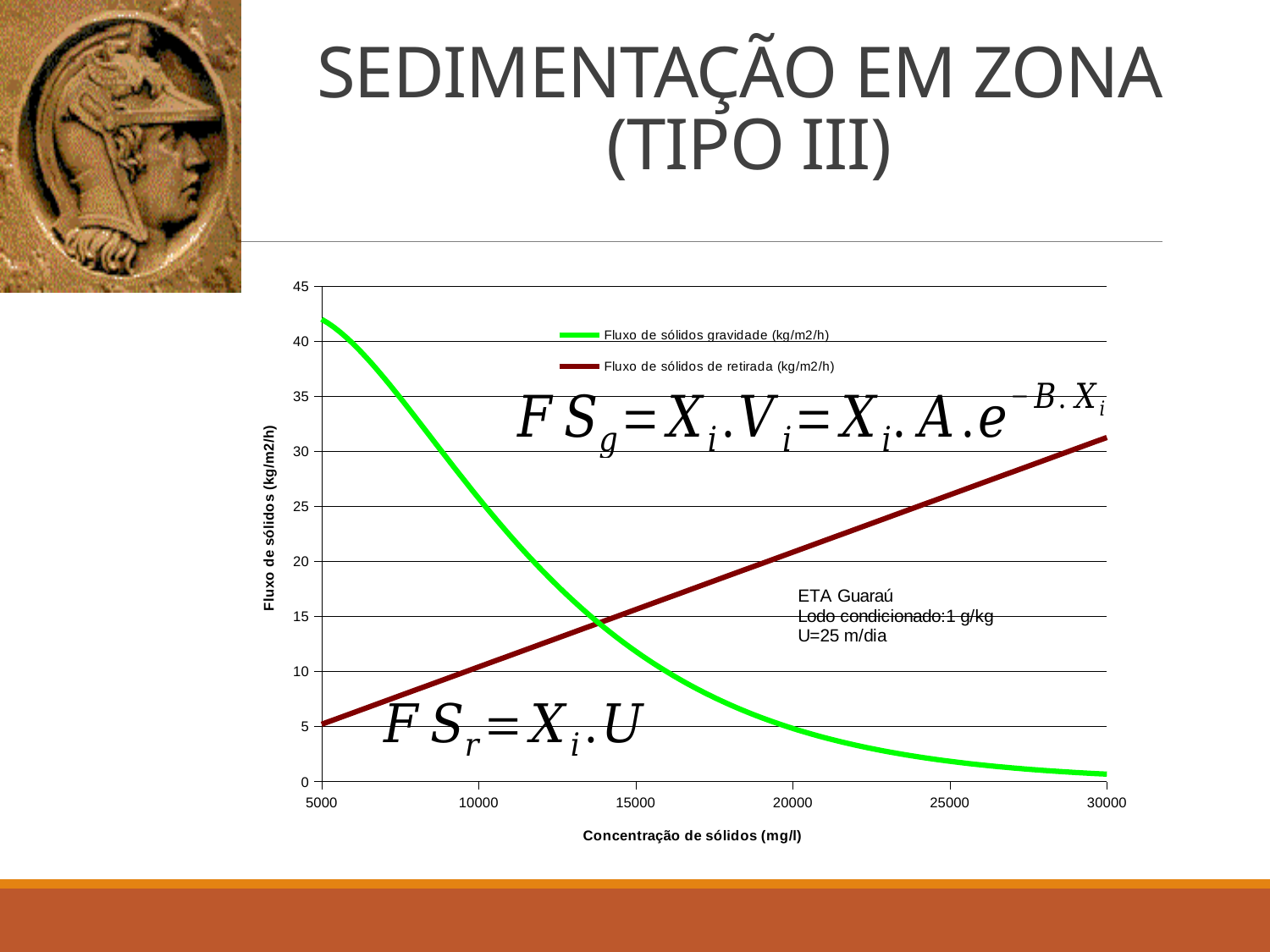
How many series does the chart legend list? 2 At a concentration of 25000 mg/l, which series has the larger value: 'Fluxo de sólidos gravidade' or 'Fluxo de sólidos de retirada'? Fluxo de sólidos de retirada What is the label of the x axis of the chart? Concentração de sólidos (mg/l) Is the value of 'Fluxo de sólidos gravidade (kg/m2/h)' at a concentration of 5000 mg/l greater or less than 40? greater Is the value of 'Fluxo de sólidos gravidade (kg/m2/h)' at a concentration of 15000 mg/l greater or less than 15? less Does the 'Fluxo de sólidos de retirada (kg/m2/h)' series rise or fall as the concentration increases along the x axis? rise At a concentration of 10000 mg/l, which series has the larger value: 'Fluxo de sólidos gravidade' or 'Fluxo de sólidos de retirada'? Fluxo de sólidos gravidade Is the value of 'Fluxo de sólidos de retirada (kg/m2/h)' at a concentration of 30000 mg/l greater or less than 25? greater What kind of chart is shown on the slide? line chart Does the 'Fluxo de sólidos gravidade (kg/m2/h)' series rise or fall as the concentration increases along the x axis? fall Which colour is used for the 'Fluxo de sólidos gravidade (kg/m2/h)' series in the chart? green